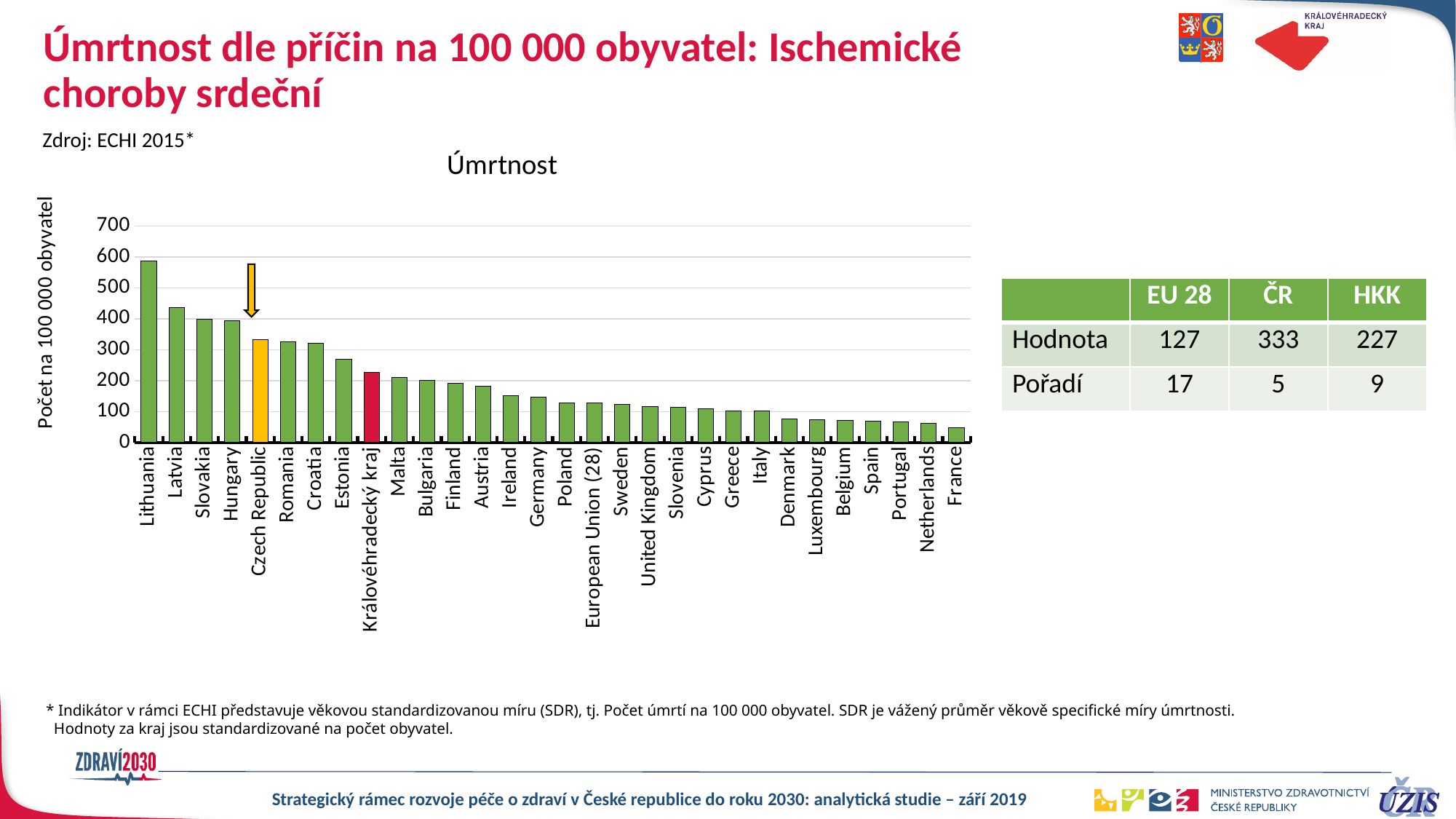
What colour is the bar for Czech Republic? yellow According to the table, what is the value (Hodnota) for ČR? 333 Do the values rise or fall from left to right along the x axis? fall What kind of chart is shown on the slide? bar chart Which country has the lowest mortality value in the chart? France Which is larger, the value for Latvia or the value for Slovakia? Latvia Is the value for France greater or less than 100? less According to the table, what is the difference between the value for ČR and the value for HKK? 106 Which country has the highest mortality value in the chart? Lithuania Is the value for Estonia greater or less than 300? less How many categories (bars) are plotted in the chart? 30 Is the value for Lithuania greater or less than 500? greater